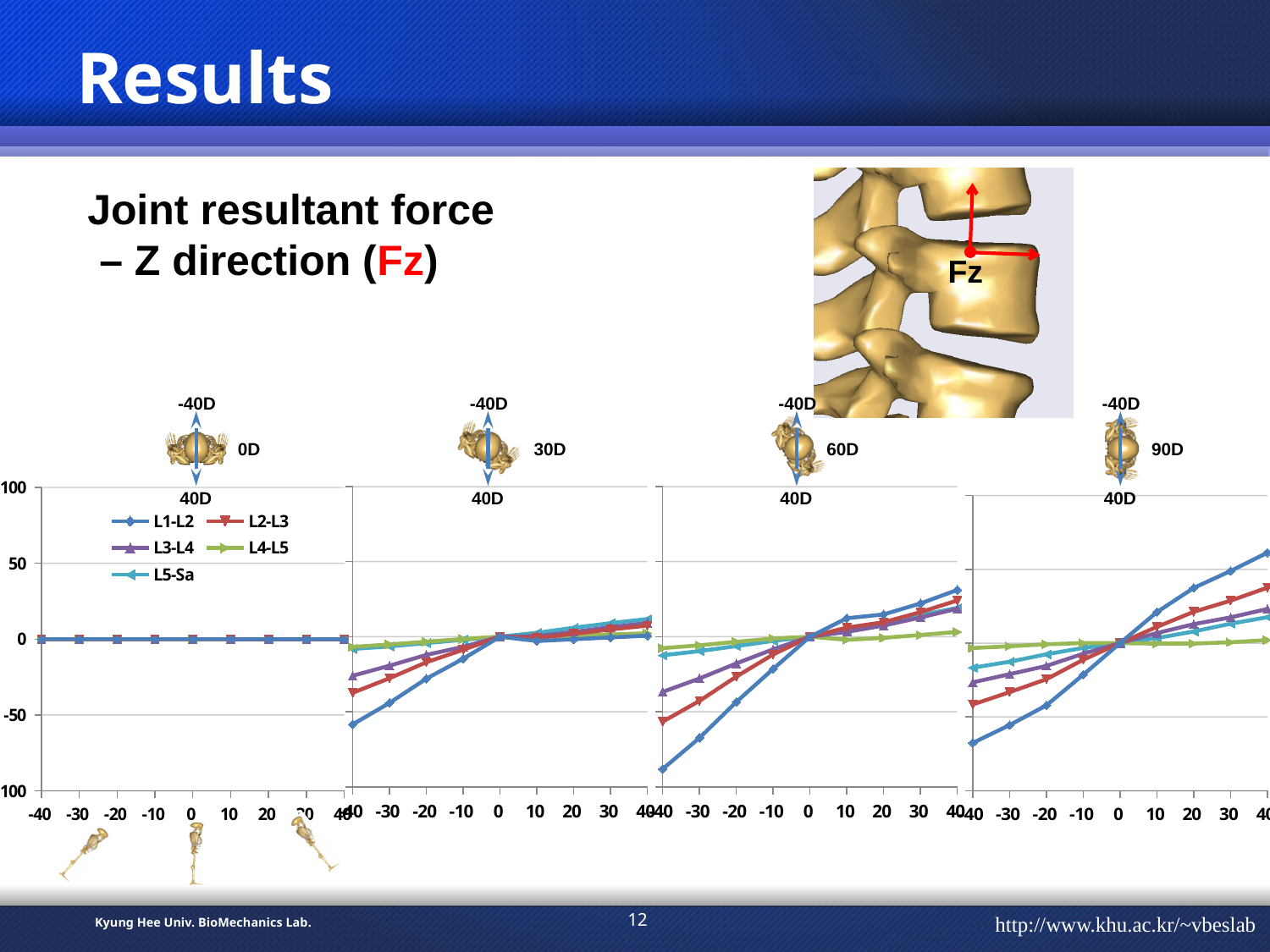
How many series does the legend on the 0D chart list? 5 In the 90D chart, does the L1-L2 series rise or fall as the x-axis value increases from -40 to 40? rise In the 60D chart, is the value of L1-L2 at x = -40 greater or less than -50? less In the 90D chart, which series has the highest value at x = 40? L1-L2 In the 90D chart, is the value of L1-L2 at x = 40 greater or less than 50? greater In the 0D chart, do the series values rise, fall, or stay flat across the x axis? stay flat What kind of chart is the 0D chart? line chart In the 90D chart, at x = 40, which is larger: L1-L2 or L4-L5? L1-L2 How many x-axis tick values are shown on the 60D chart? 9 In the 60D chart, is the value of L3-L4 at x = -40 greater or less than -50? greater How many charts are shown on the slide? 4 In the 60D chart, which series has the lowest value at x = -40? L1-L2